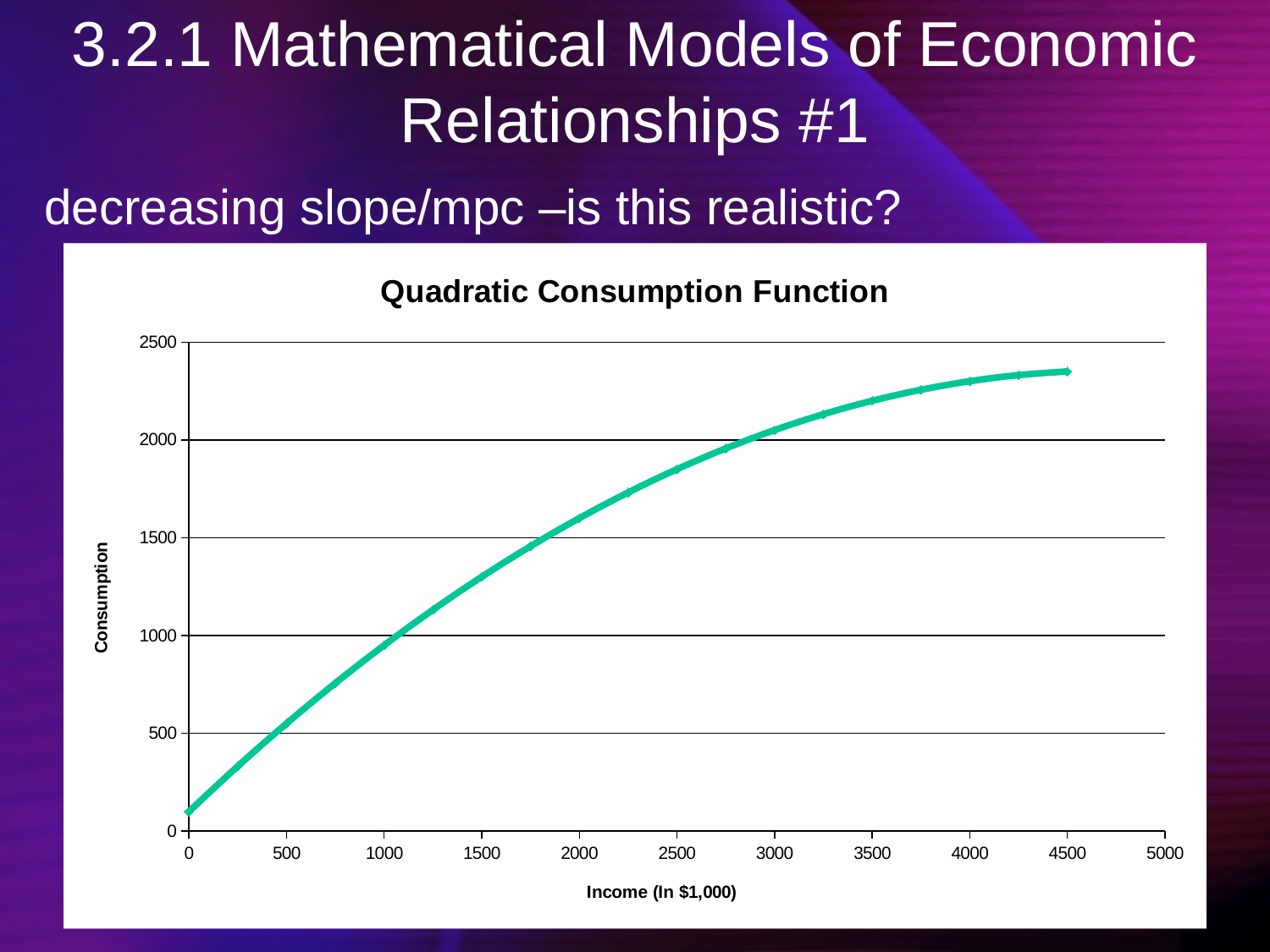
What is the title of the chart? Quadratic Consumption Function What is the label of the x axis? Income (In $1,000) Is the consumption value at an income of 4000 greater or less than 2000? greater Does consumption rise or fall as income increases along the x axis? rise What is the highest value shown on the y axis? 2500 Which is larger: consumption at an income of 500 or at an income of 4500? 4500 Is the consumption value at an income of 0 greater or less than 500? less Is the consumption value at an income of 4500 greater or less than 2500? less What kind of chart is shown on the slide? line chart